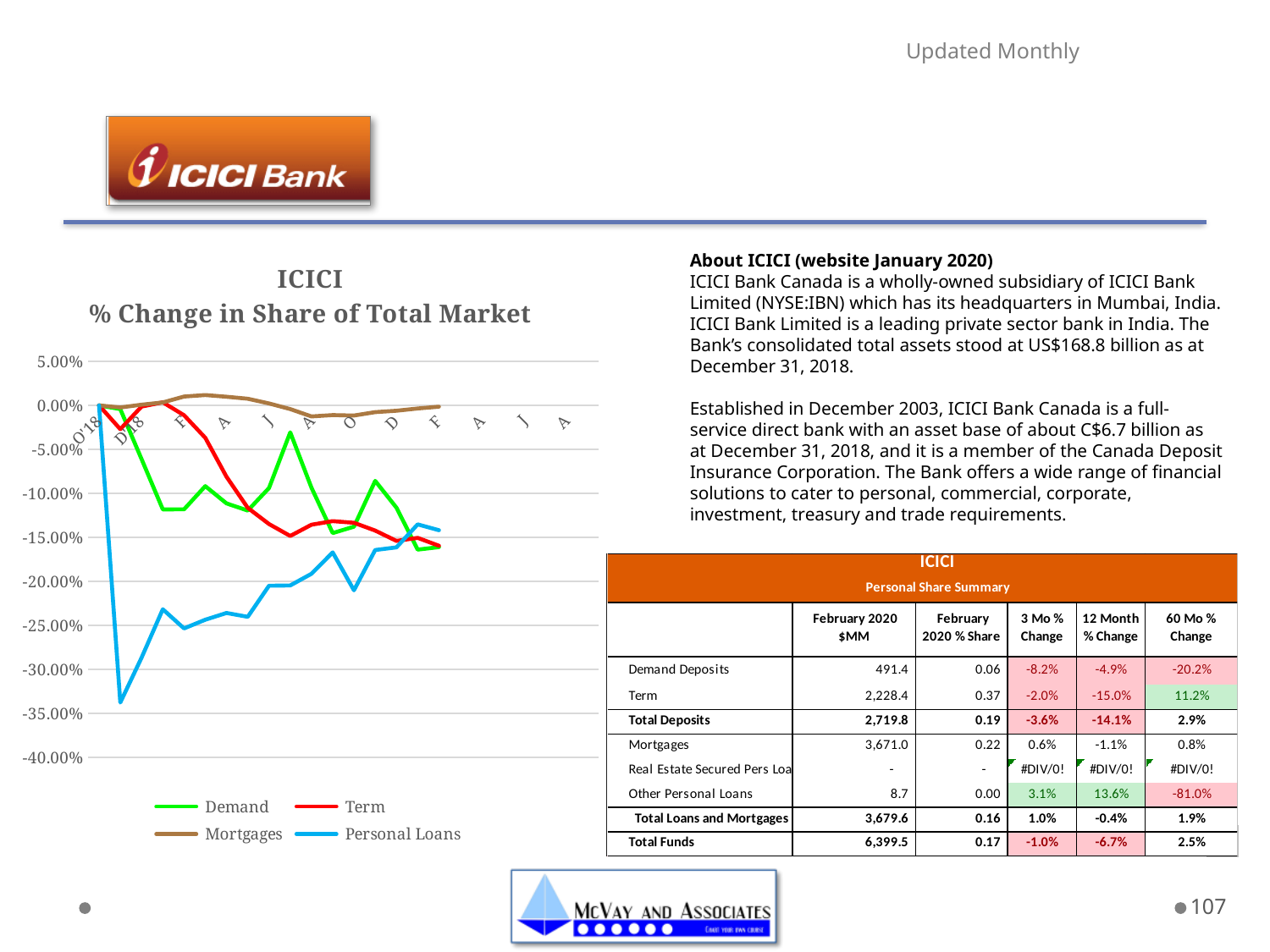
How many series does the chart legend list? 4 Which series reaches the lowest value on the chart? Personal Loans Which series stays closest to 0.00% across the whole chart? Mortgages At the D'18 point, which series has the lower value, Personal Loans or Term? Personal Loans Is the lowest value of the Mortgages series greater or less than -5.00%? greater What is the title of the chart? ICICI % Change in Share of Total Market What kind of chart is shown on the slide? Line chart Which series is drawn in blue in the chart? Personal Loans Is the lowest value of the Demand series greater or less than -10.00%? less Does the Term series rise or fall overall from O'18 to the end of the line? fall Is the lowest value of the Personal Loans series greater or less than -30.00%? less Does the Personal Loans series generally rise or fall from its low point at D'18 to the end of the line? rise